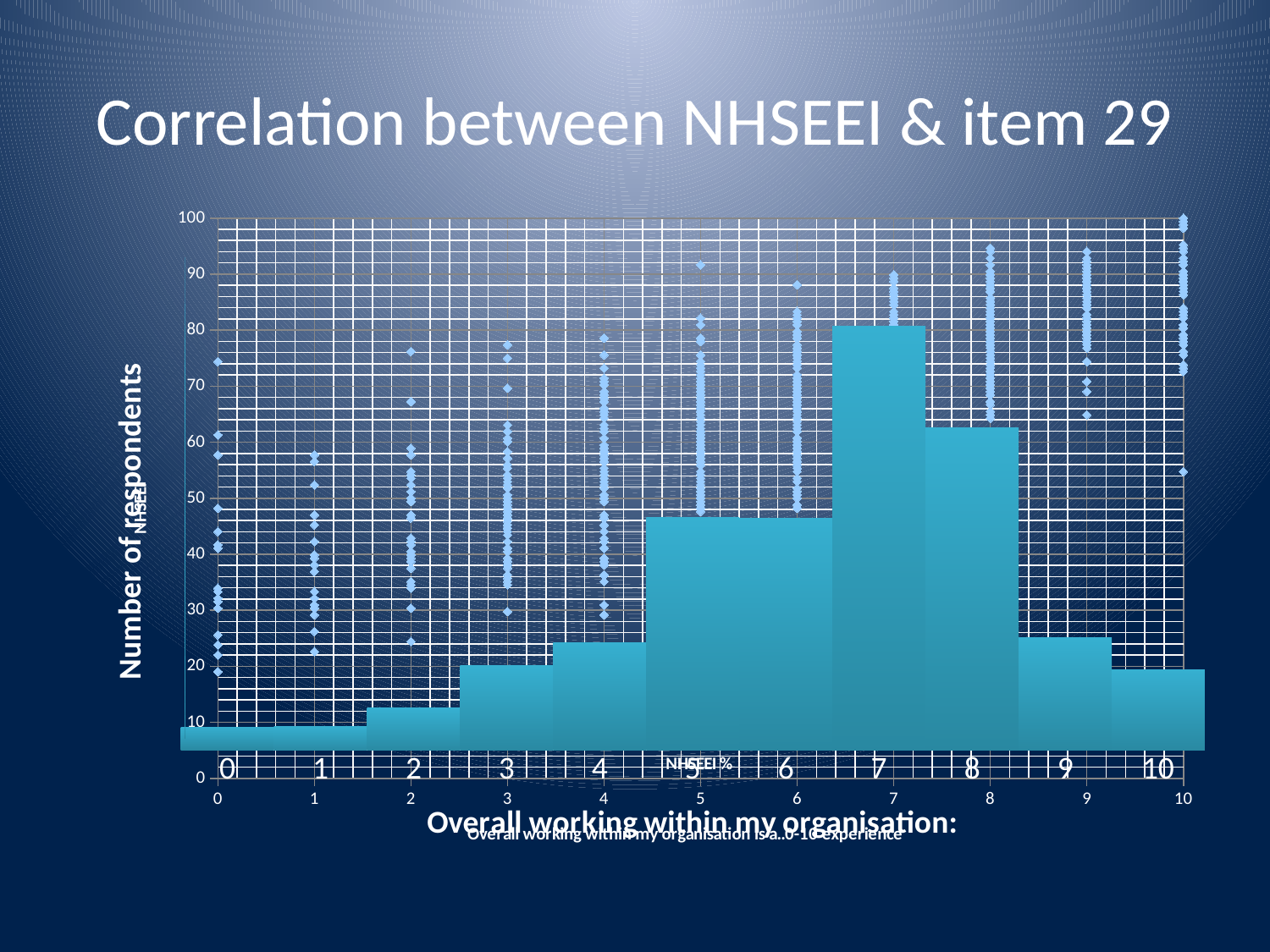
Do the bars rise or fall from rating 7 to rating 10? fall Which rating category (0-10) has the tallest bar? 7 How many rating categories are shown along the x axis? 11 Which bar is taller, rating 8 or rating 9? 8 Is the bar for rating 7 greater or less than 70? greater Is the bar for rating 9 greater or less than 20? greater What is the title of the chart? Correlation between NHSEEI & item 29 What is the label on the vertical axis? Number of respondents Is the bar for rating 8 greater or less than 50? greater Which bar is taller, rating 3 or rating 4? 4